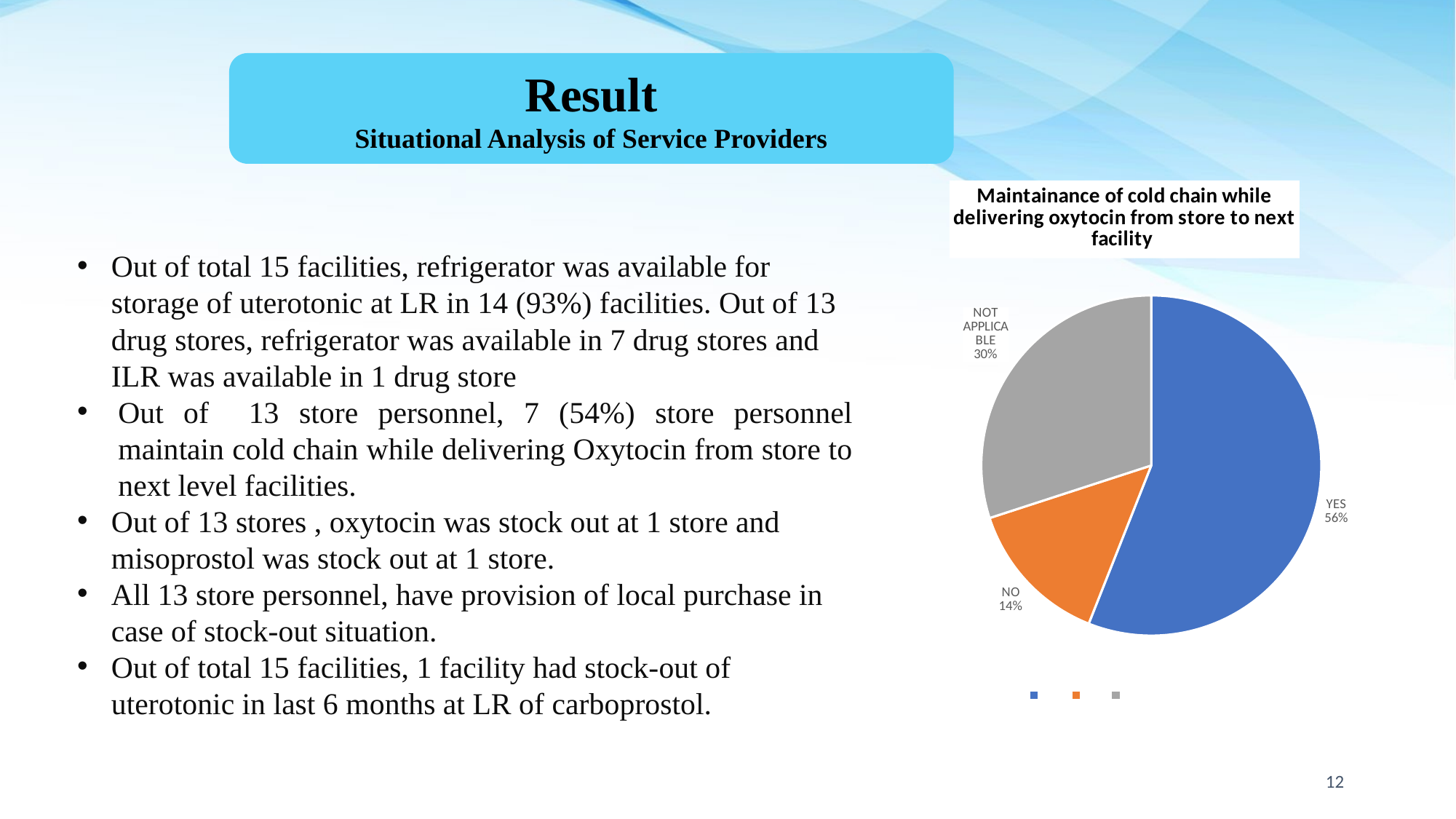
What is the title of the pie chart? Maintainance of cold chain while delivering oxytocin from store to next facility What is the difference in percentage points between the YES and NO slices? 42 How many slices does the pie chart have? 3 What is the difference in percentage points between the YES and NOT APPLICABLE slices? 26 Which slice of the pie is the largest? YES What colour is the YES slice of the pie? blue Which slice of the pie is the smallest? NO What kind of chart is shown on the slide? pie chart What share of the pie is labelled NO? 14% What share of the pie is labelled NOT APPLICABLE? 30% Which is larger, the NOT APPLICABLE slice or the NO slice? NOT APPLICABLE What share of the pie is labelled YES? 56%